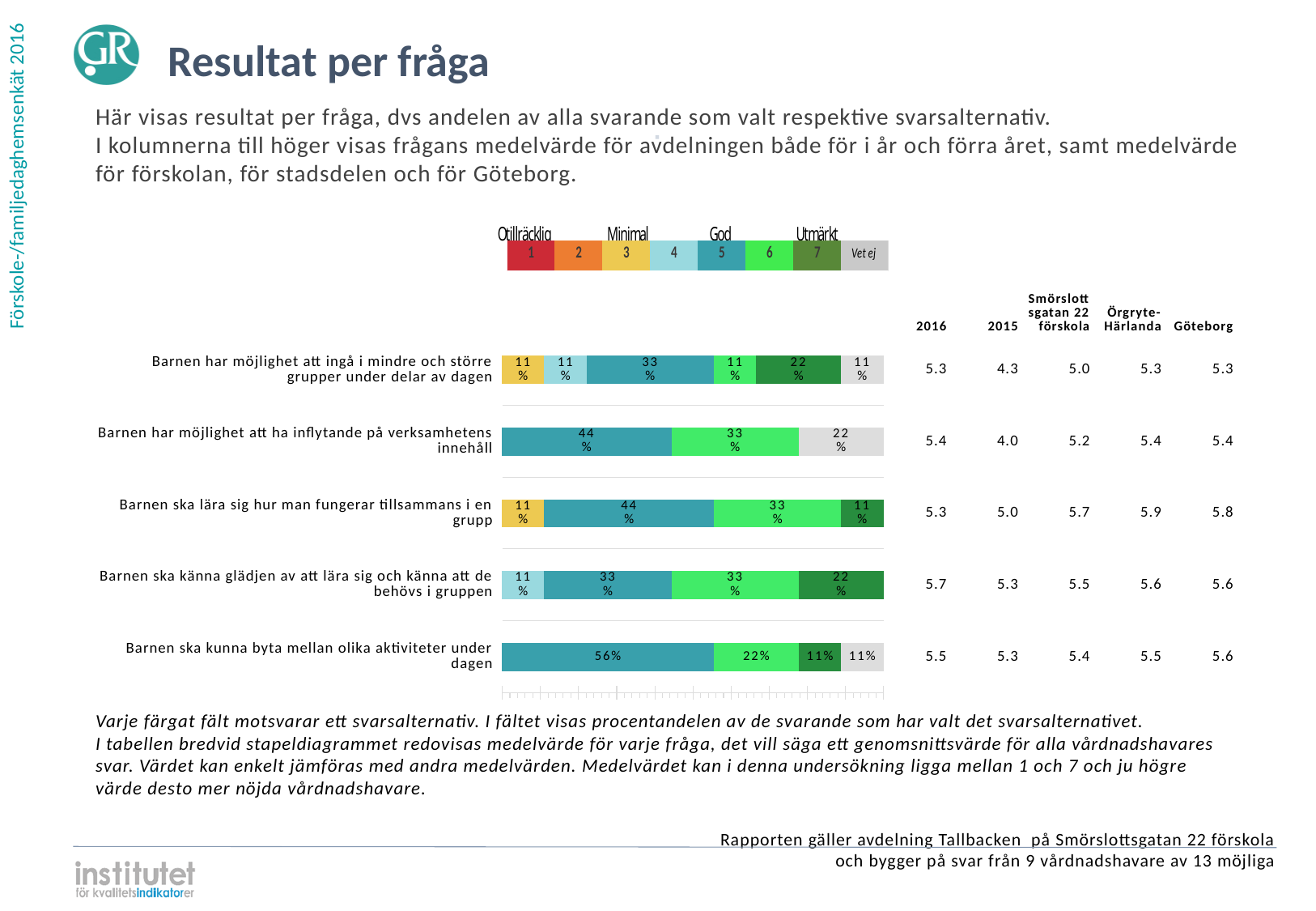
What is the combined share of answers 5 and 6 for 'Barnen har möjlighet att ha inflytande på verksamhetens innehåll'? 77% What label does the legend give to answer options 1 and 2 (the red and orange segments)? Otillräcklig Which question has the largest single segment in its bar? Barnen ska kunna byta mellan olika aktiviteter under dagen What is the 2016 mean value shown for 'Barnen ska känna glädjen av att lära sig och känna att de behövs i gruppen'? 5.7 What percentage of respondents chose answer 5 (God, teal) for 'Barnen ska kunna byta mellan olika aktiviteter under dagen'? 56% What percentage chose answer 7 (dark green) for 'Barnen ska känna glädjen av att lära sig och känna att de behövs i gruppen'? 22% For 'Barnen har möjlighet att ingå i mindre och större grupper under delar av dagen', which is larger: the share choosing answer 5 or the share choosing answer 7? Answer 5 (33%) What kind of chart is used to show the results per question on this slide? Stacked bar chart For 'Barnen ska lära sig hur man fungerar tillsammans i en grupp', what is the difference between the share choosing answer 5 (44%) and the share choosing answer 3 (11%)? 33 percentage points How many questions (bars) are shown in the chart? 5 What percentage chose 'Vet ej' for 'Barnen har möjlighet att ha inflytande på verksamhetens innehåll'? 22% How many answer categories does the legend above the chart list, including 'Vet ej'? 8